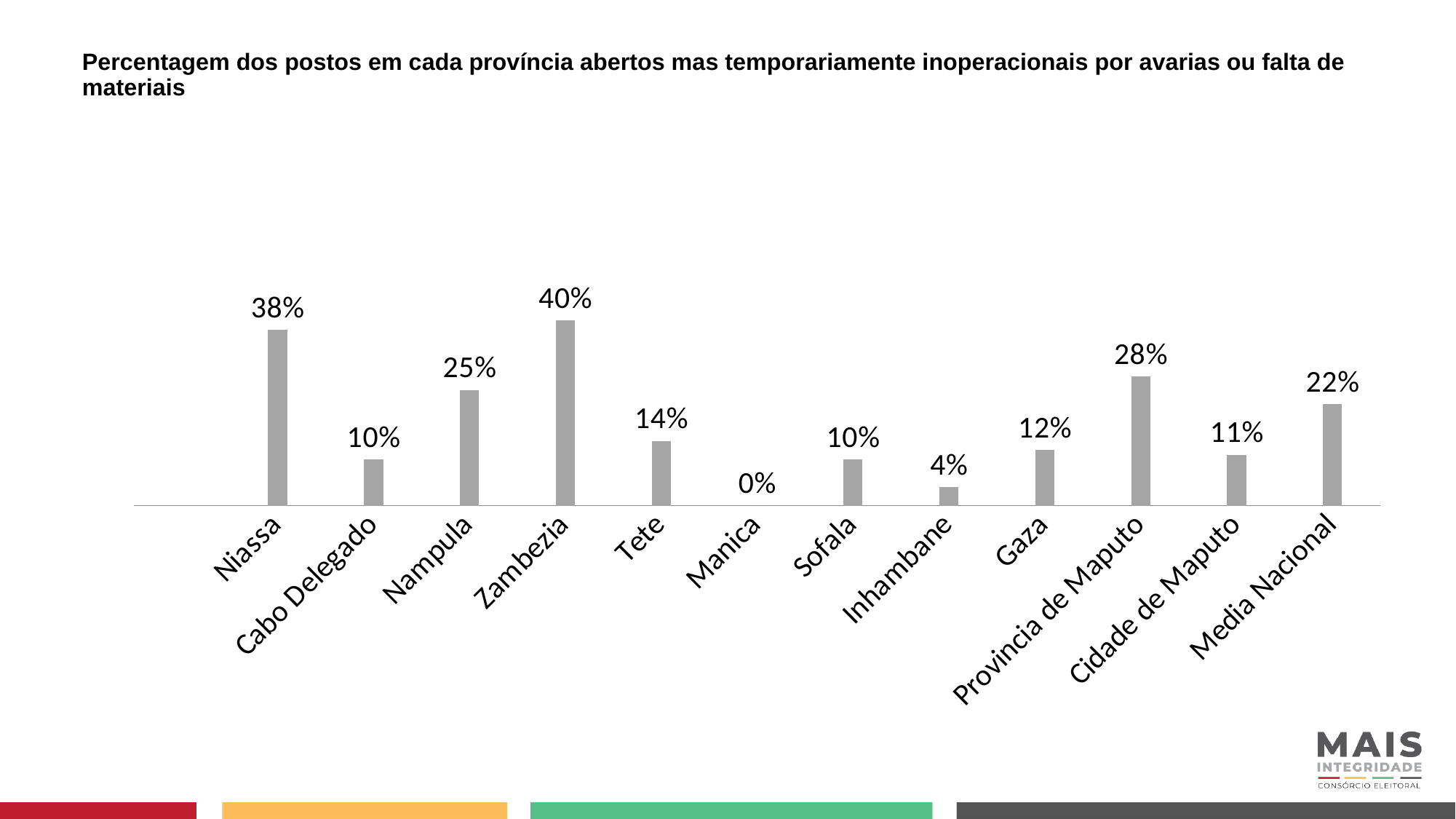
What colour are the bars in the chart? Grey What is the difference between the values for Niassa and Nampula? 13% What kind of chart is shown on the slide? Bar chart Which is larger, the value for Niassa or the value for Provincia de Maputo? Niassa What is the difference between the values for Tete and Inhambane? 10% Which province has the highest value? Zambezia What is the value for Media Nacional? 22% What is the value for Zambezia? 40% What is the value for Provincia de Maputo? 28% Which province has the lowest value? Manica How many categories are shown on the x axis? 12 Which is larger, the value for Gaza or the value for Cidade de Maputo? Gaza